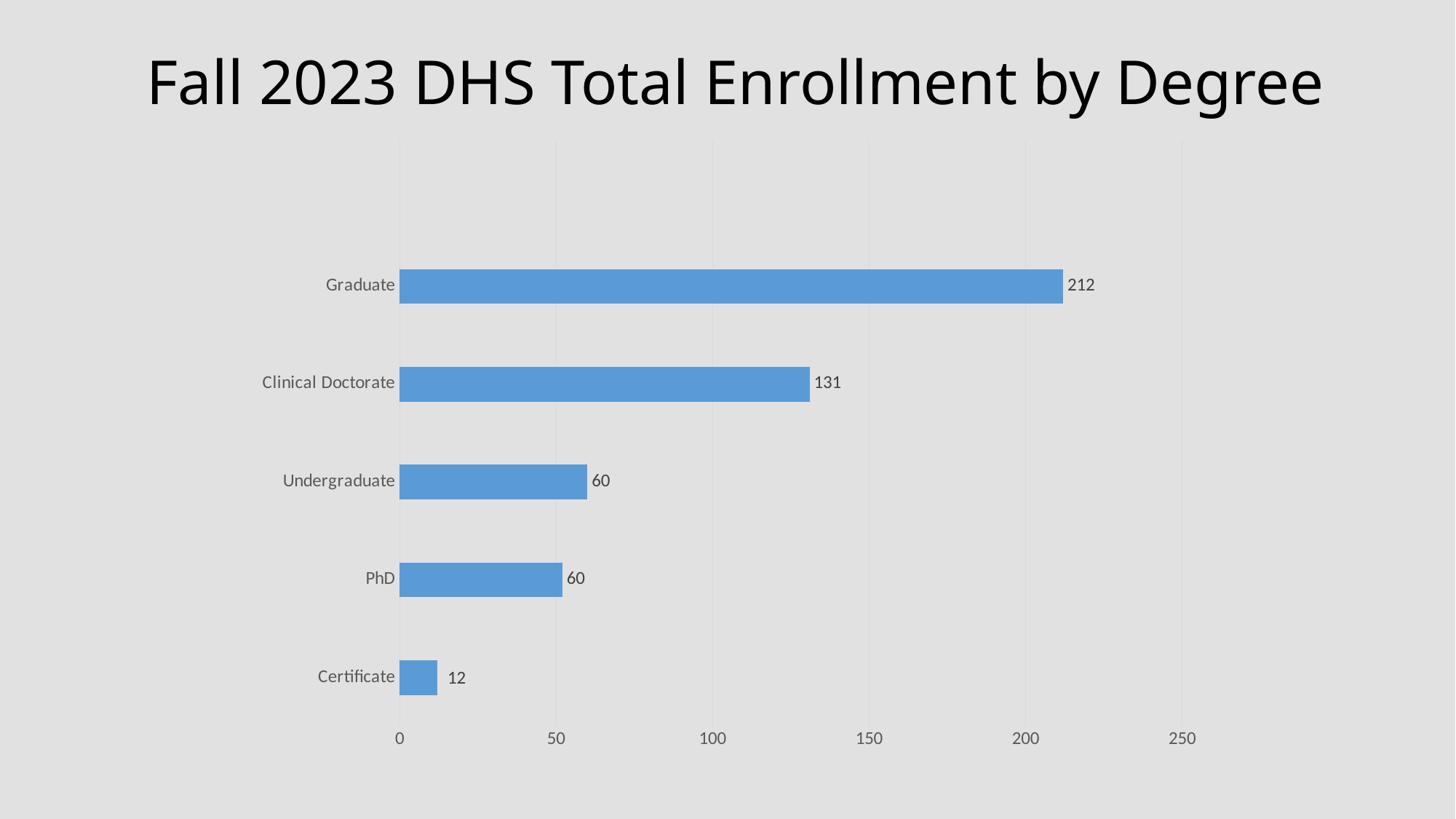
What kind of chart is shown on the slide? Bar chart Which degree category has the lowest enrollment? Certificate What is the difference between the Graduate and Clinical Doctorate enrollment values? 81 What is the enrollment value for Undergraduate? 60 How many degree categories are shown in the chart? 5 Which degree category has the highest enrollment? Graduate What is the enrollment value for Clinical Doctorate? 131 What is the enrollment value for Graduate? 212 What is the enrollment value for Certificate? 12 Which is larger, the enrollment for Clinical Doctorate or for PhD? Clinical Doctorate Is the value for Clinical Doctorate greater or less than 100? greater What is the title of the chart? Fall 2023 DHS Total Enrollment by Degree